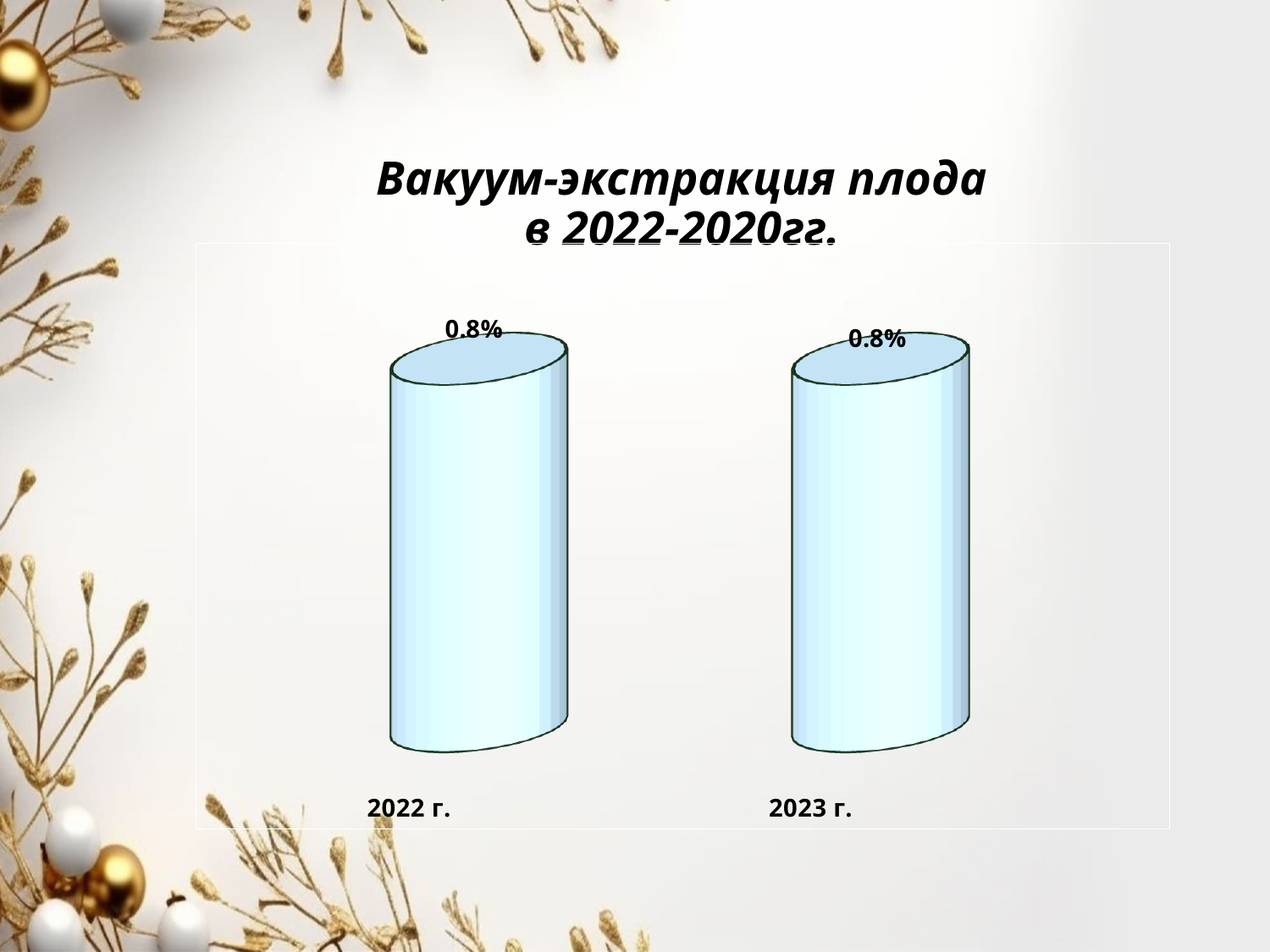
Do the values rise, fall, or stay the same from 2022 г. to 2023 г.? Stay the same Which years are labelled on the x axis of the chart? 2022 г. and 2023 г. Is the value for 2023 г. greater than, less than, or equal to the value for 2022 г.? Equal What is the value for 2022 г.? 0.8% What is the value for 2023 г.? 0.8% What is the title of the chart? Вакуум-экстракция плода в 2022-2020гг. What kind of chart is shown on the slide? Bar chart How many categories are shown on the chart? 2 What is the difference between the values for 2022 г. and 2023 г.? 0.0%